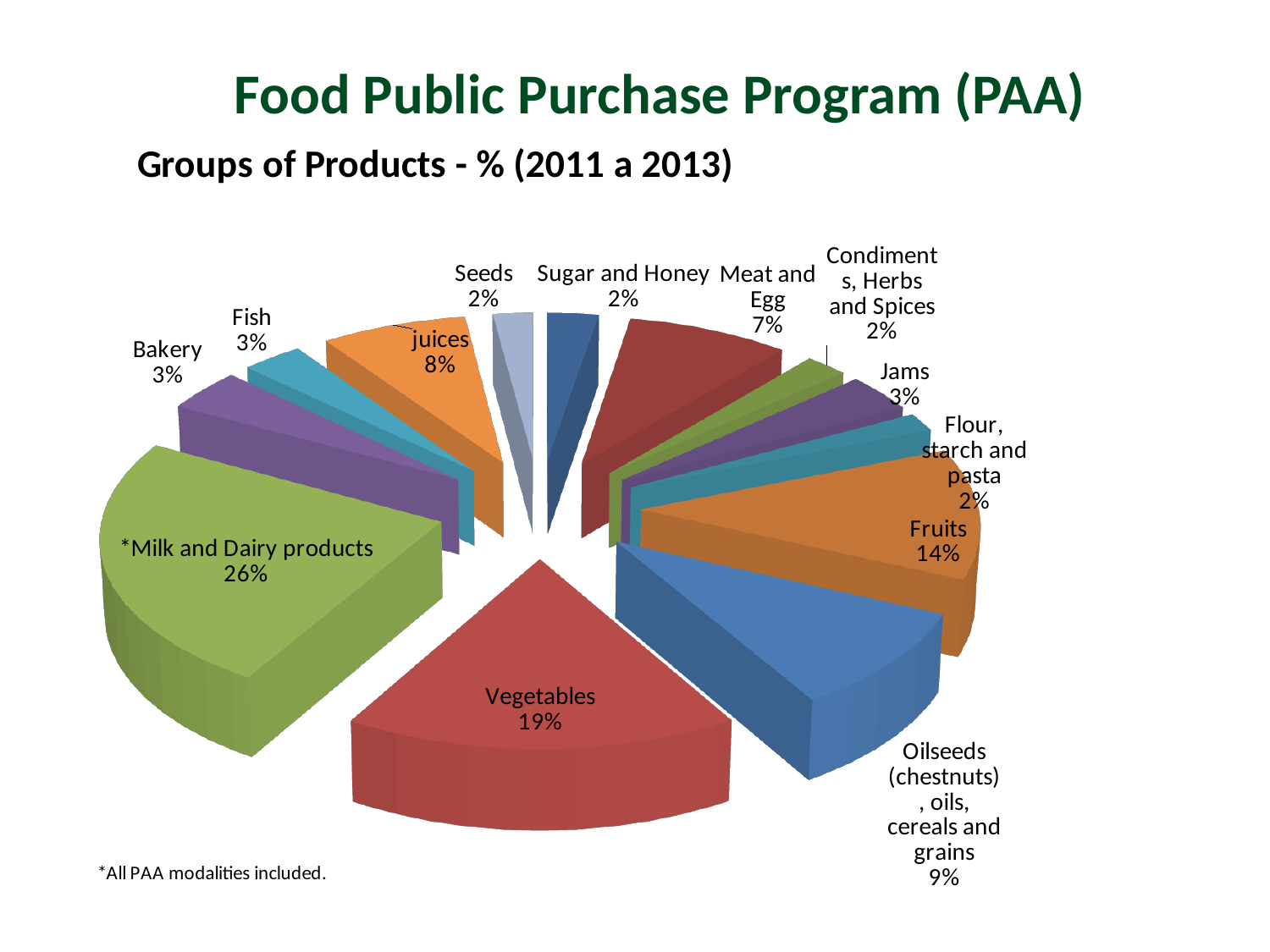
What is the share of the largest slice, Milk and Dairy products? 26% What kind of chart is shown on the slide? Pie chart Which group of products has the largest share of the pie? Milk and Dairy products What period does the chart subtitle say the percentages cover? 2011 a 2013 What is the difference in percentage points between Milk and Dairy products and Vegetables? 7 How many product groups are shown in the pie chart? 13 What share of the pie is Vegetables? 19% What is the combined share of Bakery and Fish? 6% What percentage is shown for Meat and Egg? 7% Which is larger, the share for Fruits or the share for Oilseeds (chestnuts), oils, cereals and grains? Fruits What percentage is shown for Fruits? 14% What percentage is shown for juices? 8%